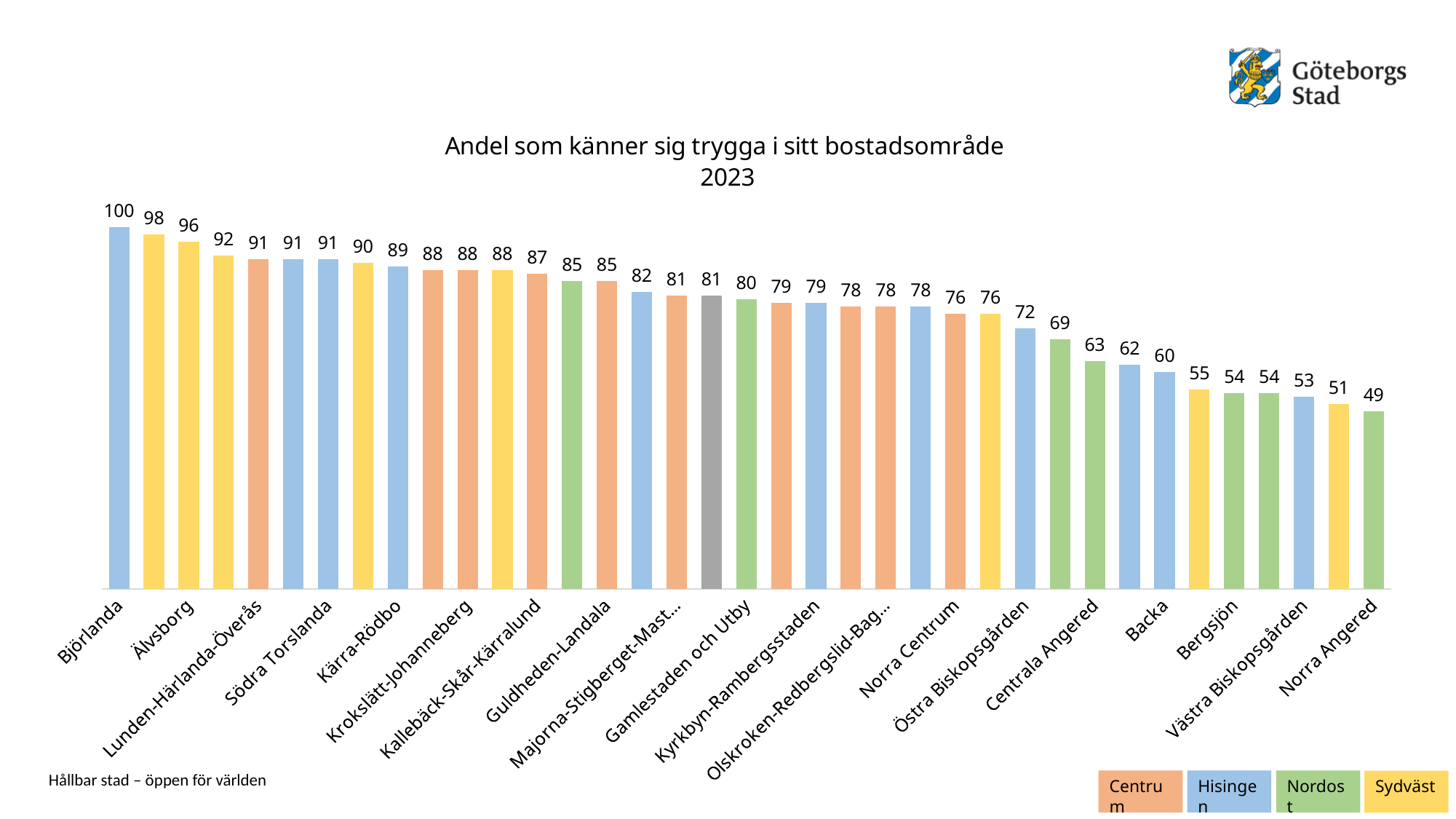
What is the value for Norra Angered? 49 What kind of chart is shown? Bar chart What is the difference between the values for Kärra-Rödbo and Backa? 29 Which has a larger value, Centrala Angered or Bergsjön? Centrala Angered Which area has the highest value? Björlanda What is the value for Björlanda? 100 What is the difference between the values for Björlanda and Norra Angered? 51 Which area has the lowest value? Norra Angered What is the value for Östra Biskopsgården? 72 What is the value for Gamlestaden och Utby? 80 How many series does the legend list? 4 What is the title of the chart? Andel som känner sig trygga i sitt bostadsområde 2023